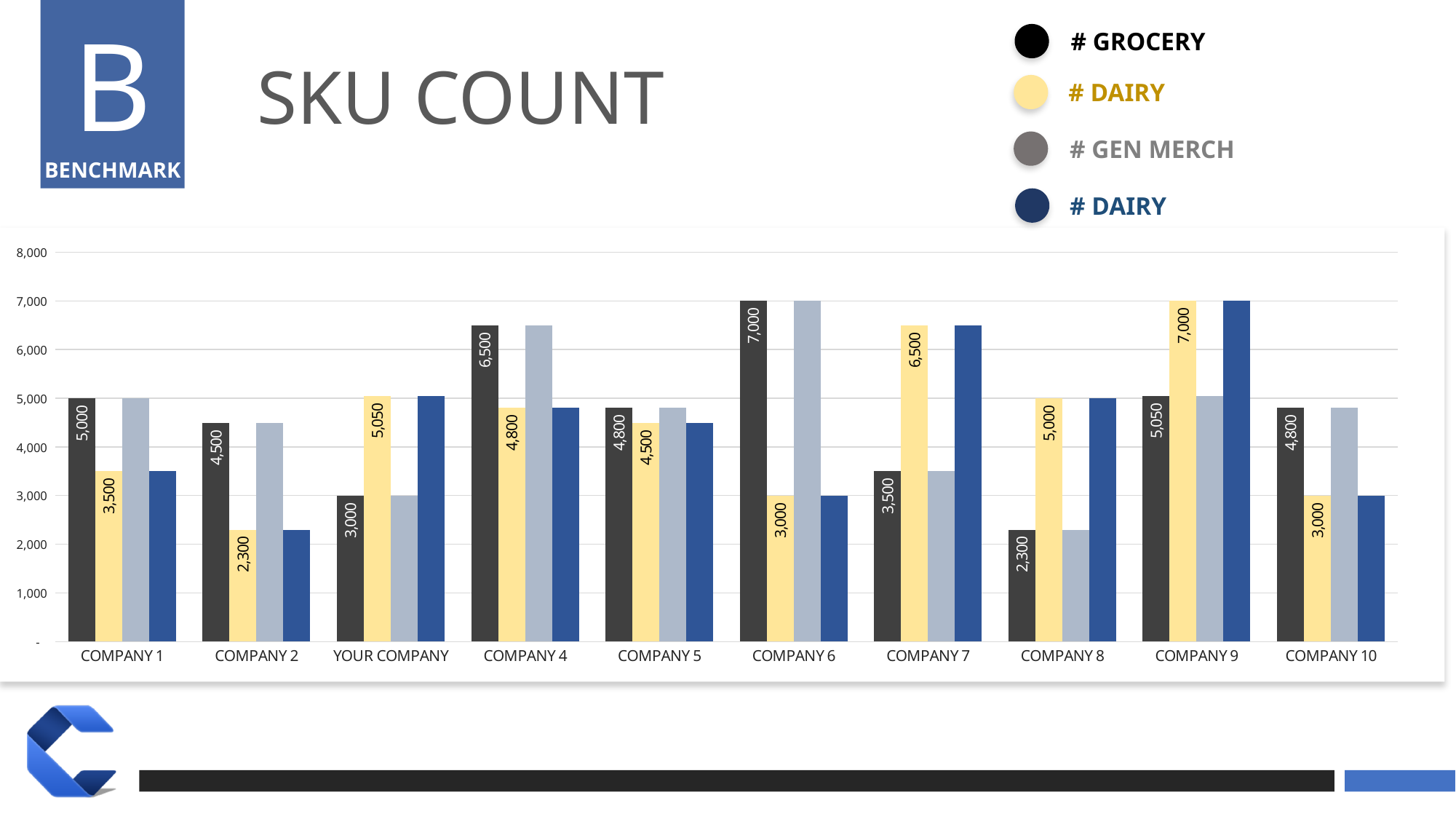
Which company has the highest value in the yellow # DAIRY series? COMPANY 9 What kind of chart is shown on the slide? Bar chart Is the # GEN MERCH value for COMPANY 6 greater or less than 6,000? greater For COMPANY 7, which is larger: the # GROCERY value or the yellow # DAIRY value? The yellow # DAIRY value What is the value of the yellow # DAIRY series for YOUR COMPANY? 5,050 Which company has the highest # GROCERY value? COMPANY 6 What is the difference between the # GROCERY value and the yellow # DAIRY value for COMPANY 4? 1,700 What is the # GROCERY value for COMPANY 6? 7,000 How many series does the legend list? 4 What is the # GROCERY value for COMPANY 8? 2,300 Which company has the lowest value in the yellow # DAIRY series? COMPANY 2 How many companies are shown on the x axis? 10